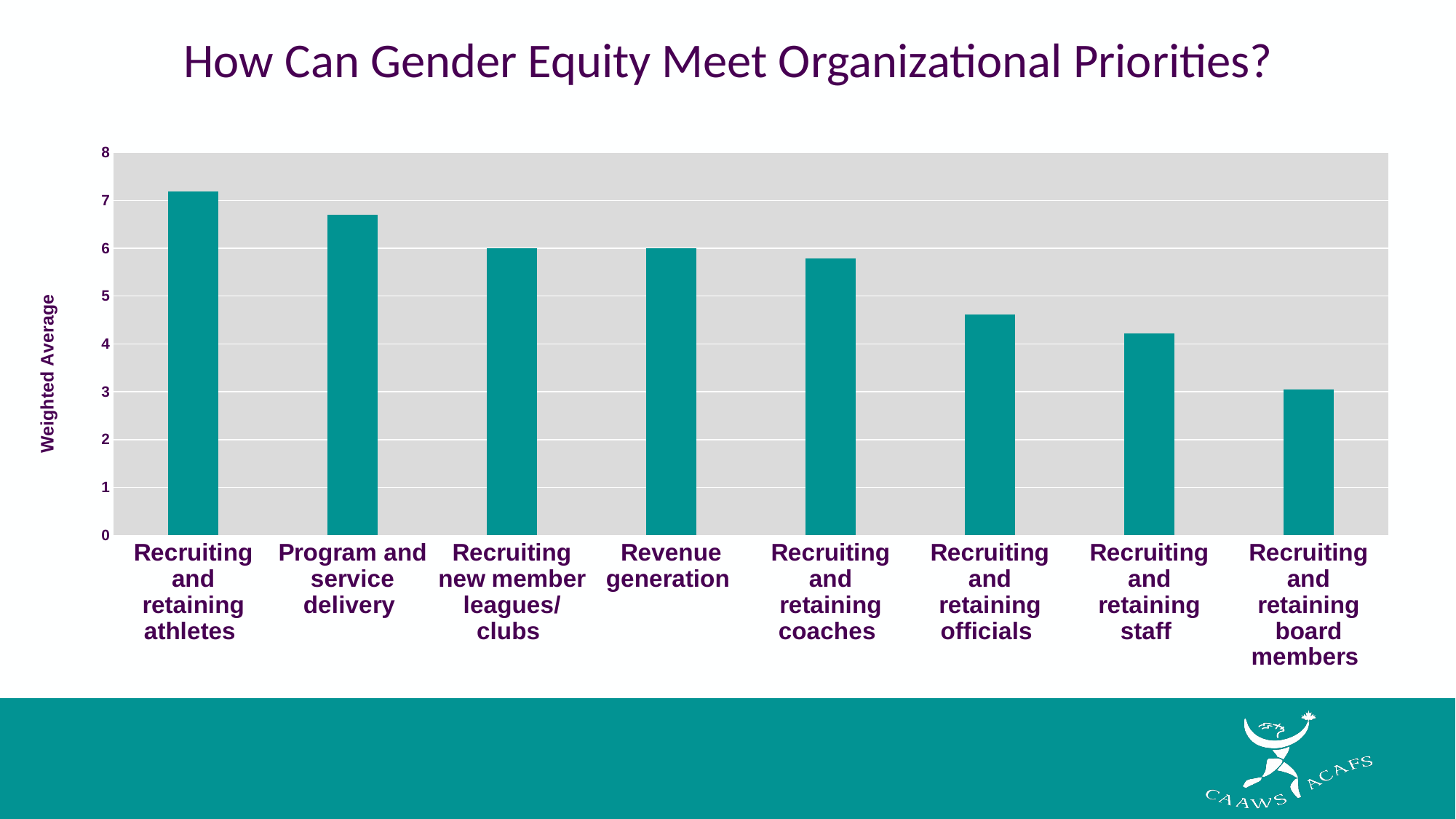
Is the weighted average for Recruiting and retaining board members greater or less than 4? less What is the label on the vertical axis of the chart? Weighted Average What kind of chart is shown on the slide? bar chart Is the weighted average for Recruiting and retaining coaches greater or less than 6? less How many categories are plotted in the chart? 8 Do the bar values rise or fall from left to right across the chart? fall Is the weighted average for Recruiting and retaining athletes greater or less than 7? greater Which category has the lowest weighted average? Recruiting and retaining board members Which has a higher weighted average: Recruiting and retaining athletes or Program and service delivery? Recruiting and retaining athletes Which category has the highest weighted average? Recruiting and retaining athletes Which has a higher weighted average: Recruiting and retaining officials or Recruiting and retaining staff? Recruiting and retaining officials